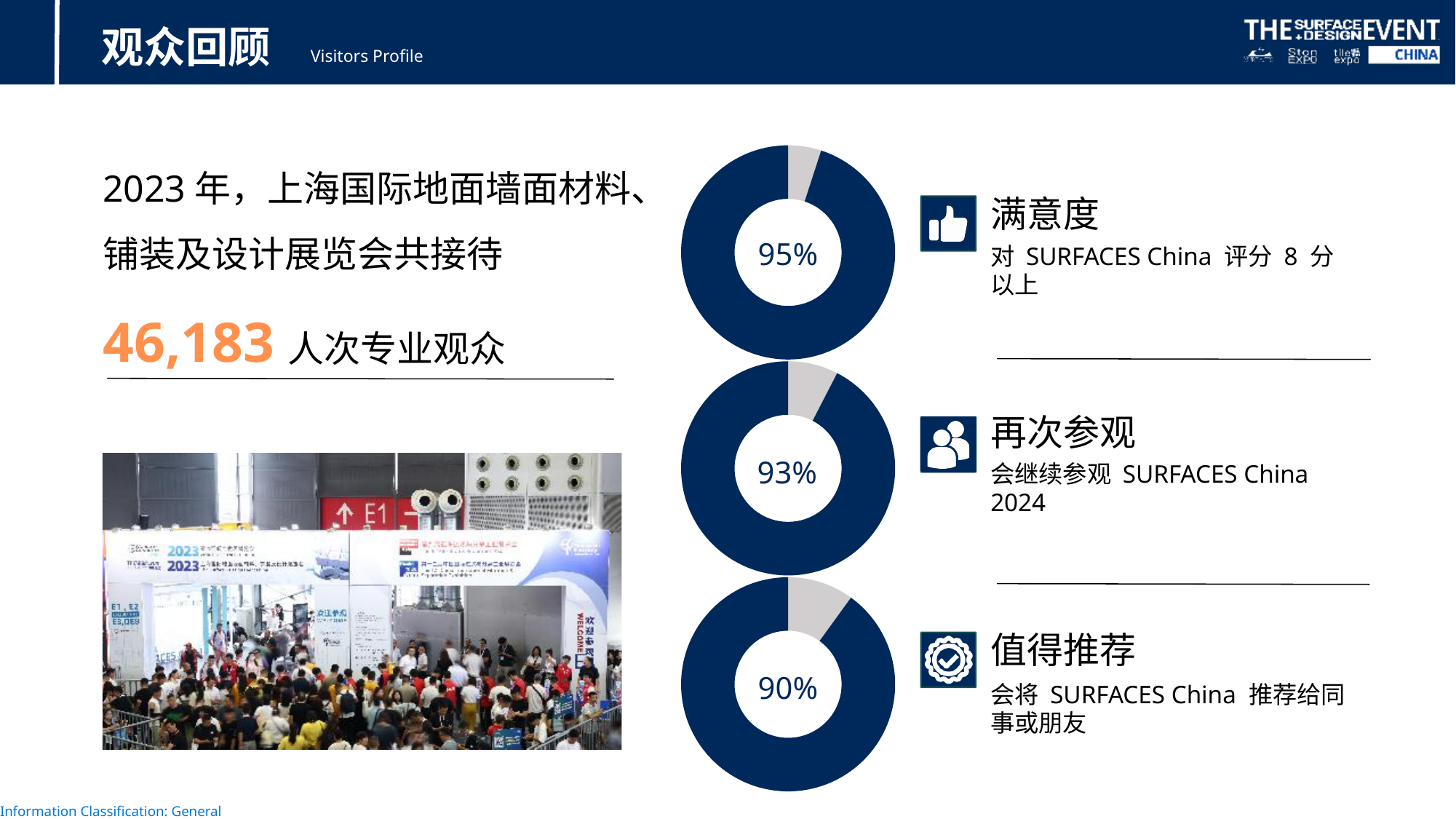
What is the difference between the percentage in the top donut chart (满意度) and the bottom donut chart (值得推荐)? 5% Which of the three donut charts shows the lowest percentage? 值得推荐 (90%) How many donut charts are shown on the slide? 3 What kind of chart is used to show the 满意度 (satisfaction) figure on the slide? Donut chart In the middle donut chart (再次参观), what percentage is shown in the centre? 93% What colour is the filled (major) portion of each donut chart? Dark navy blue Which of the three donut charts shows the highest percentage? 满意度 (95%) Do the percentages in the donut charts increase or decrease going from the top chart to the bottom chart? Decrease In the bottom donut chart (值得推荐), what percentage is shown in the centre? 90% What is the difference between the percentage in the middle donut chart (再次参观) and the bottom donut chart (值得推荐)? 3% In the top donut chart (满意度), what percentage is shown in the centre? 95% Which is larger: the percentage in the top donut chart (满意度) or the middle donut chart (再次参观)? 满意度 (95%)